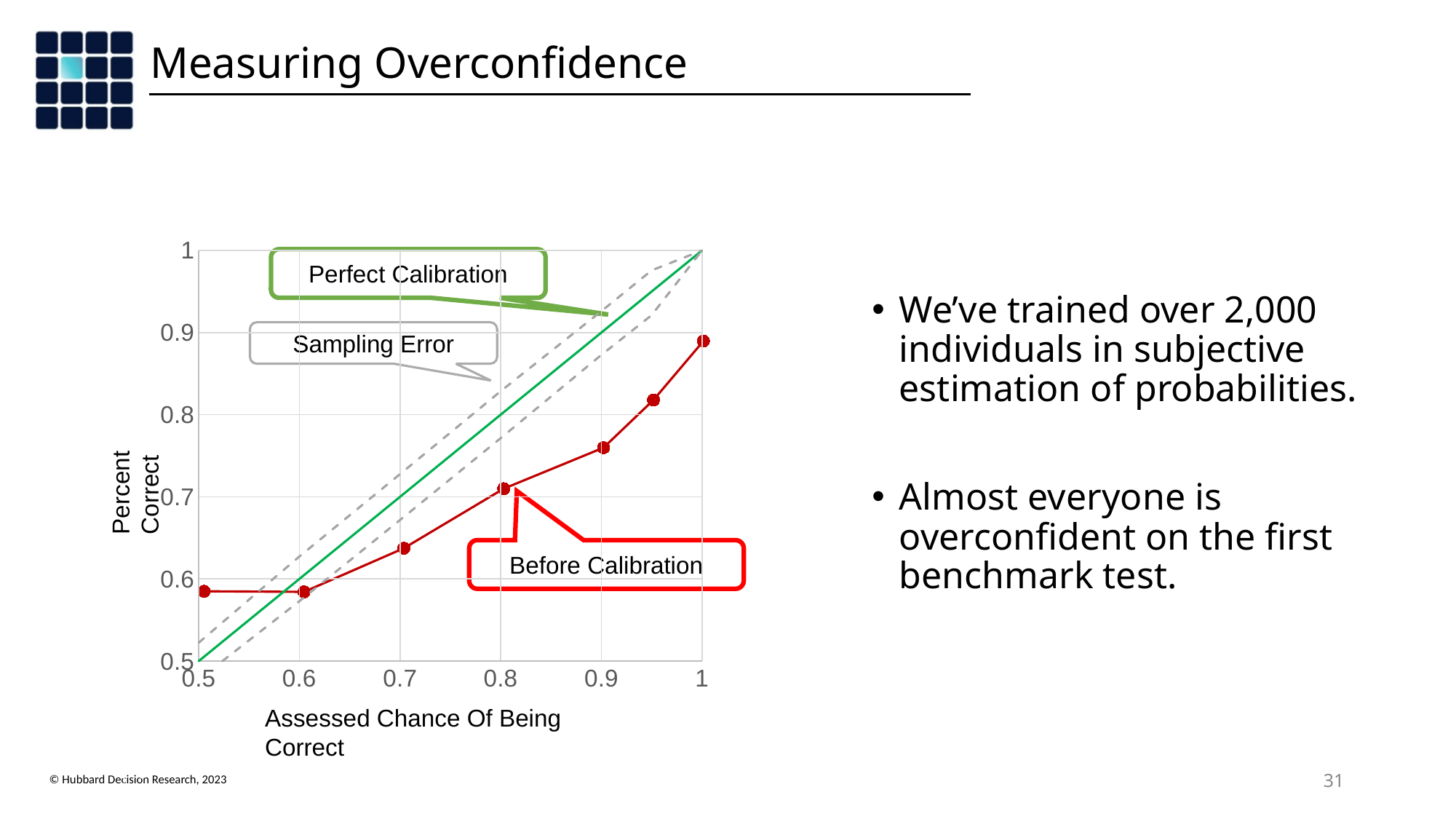
Is the Before Calibration percent correct at an assessed chance of 1 greater or less than 0.8? greater Is the Before Calibration percent correct at an assessed chance of 0.9 greater or less than 0.8? less Which is larger for the Before Calibration line: the percent correct at an assessed chance of 0.9 or at 0.7? 0.9 What is the title of the x axis? Assessed Chance Of Being Correct What kind of chart is shown on the slide? line chart What is the title of the y axis? Percent Correct At which assessed chance of being correct does the Before Calibration line reach its highest percent correct? 1 Is the Before Calibration percent correct at an assessed chance of 0.9 greater or less than 0.7? greater Which line is labelled as the green line? Perfect Calibration How many data points are plotted on the Before Calibration line? 7 Does the Before Calibration line generally rise or fall as the assessed chance of being correct increases? rise